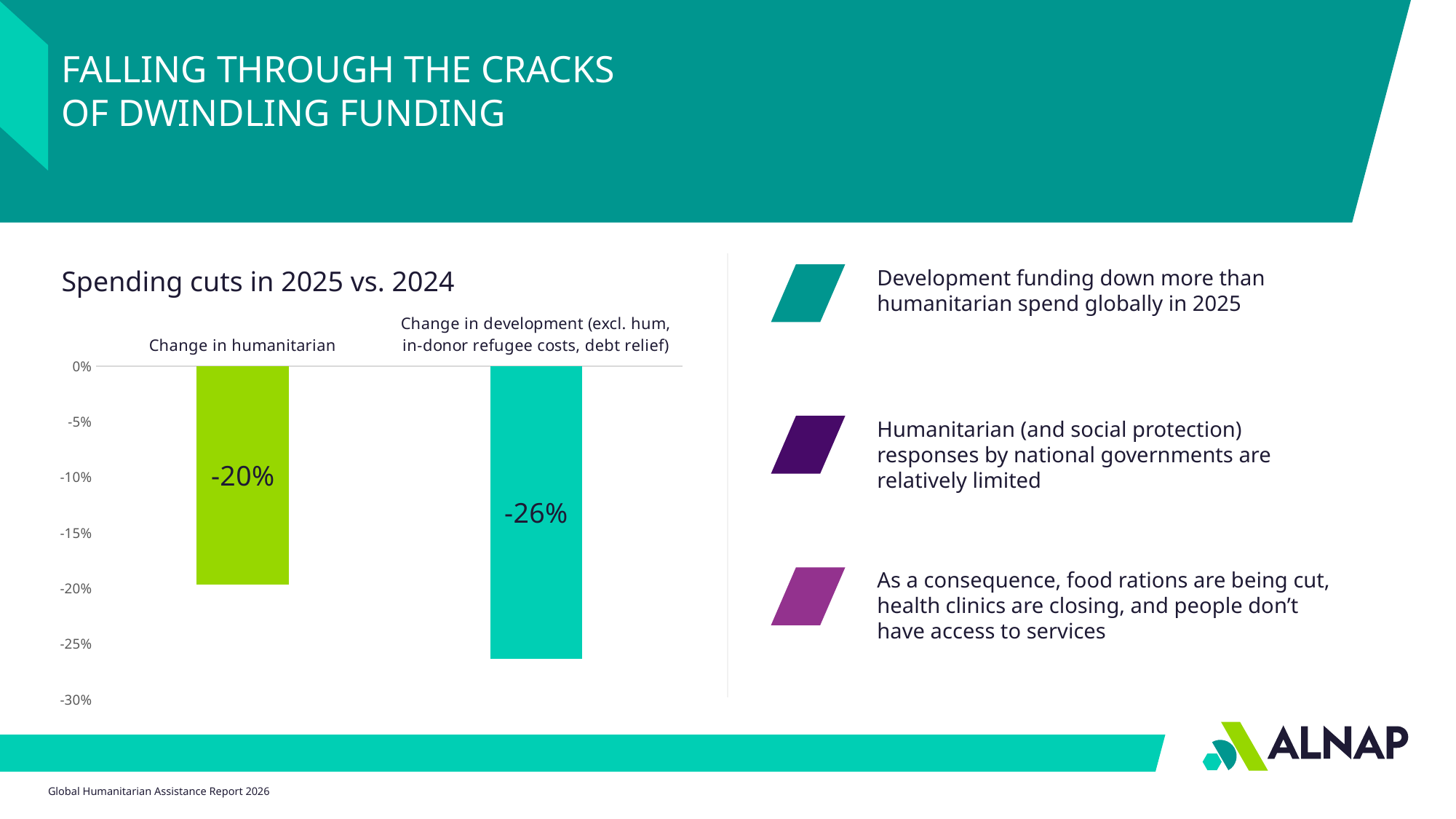
Is the value for 'Change in development' greater or less than -25%? less What is the value for 'Change in humanitarian'? -20% How many categories are plotted in the chart? 2 Is the value for 'Change in humanitarian' greater or less than -15%? less What kind of chart is shown on the slide? bar chart Which category shows the smaller spending cut? Change in humanitarian What is the difference in percentage points between the humanitarian change and the development change? 6 percentage points Which category shows the larger spending cut? Change in development (excl. hum, in-donor refugee costs, debt relief) What colour is the bar for 'Change in humanitarian'? green What is the value for 'Change in development (excl. hum, in-donor refugee costs, debt relief)'? -26% What is the title of the chart? Spending cuts in 2025 vs. 2024 Is the cut in development funding larger or smaller than the cut in humanitarian funding? larger